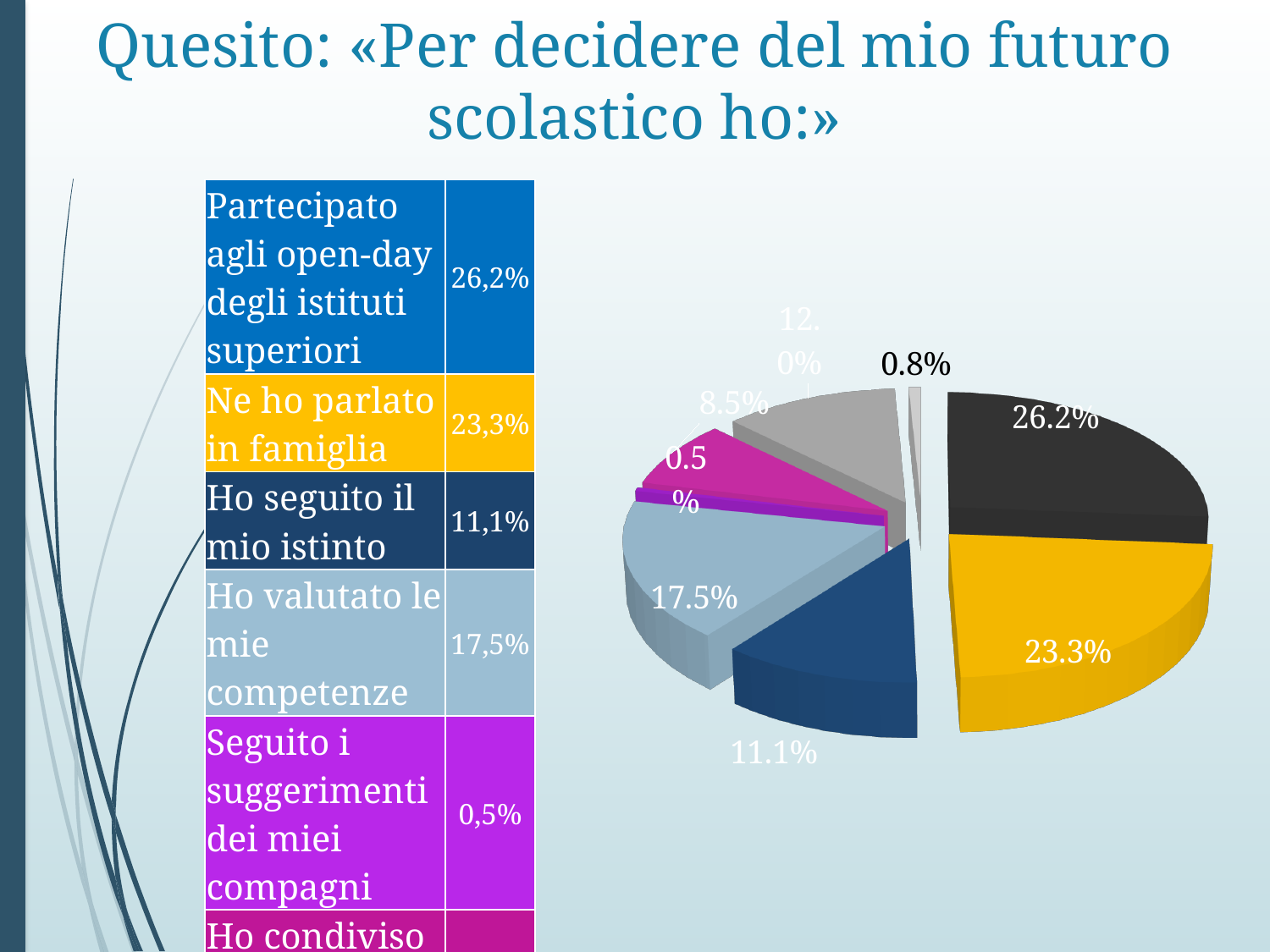
What kind of chart is shown on the slide? pie chart According to the table, what percentage of respondents chose 'Ho valutato le mie competenze'? 17,5% How many slices does the pie chart have? 8 Which is larger in the pie chart: the slice for 'Ho valutato le mie competenze' or the slice for 'Ho seguito il mio istinto'? Ho valutato le mie competenze According to the table, what percentage of respondents chose 'Seguito i suggerimenti dei miei compagni'? 0,5% According to the table, what percentage of respondents chose 'Ne ho parlato in famiglia'? 23,3% Which option in the table has the highest percentage? Partecipato agli open-day degli istituti superiori What is the difference in percentage points between the 26.2% slice and the 23.3% slice of the pie chart? 2.9 According to the table, what percentage of respondents chose 'Ho seguito il mio istinto'? 11,1% In the pie chart, what percentage is shown for the largest slice? 26.2% In the pie chart, what percentage is shown for the smallest slice? 0.5% What colour is the 23.3% slice in the pie chart? yellow